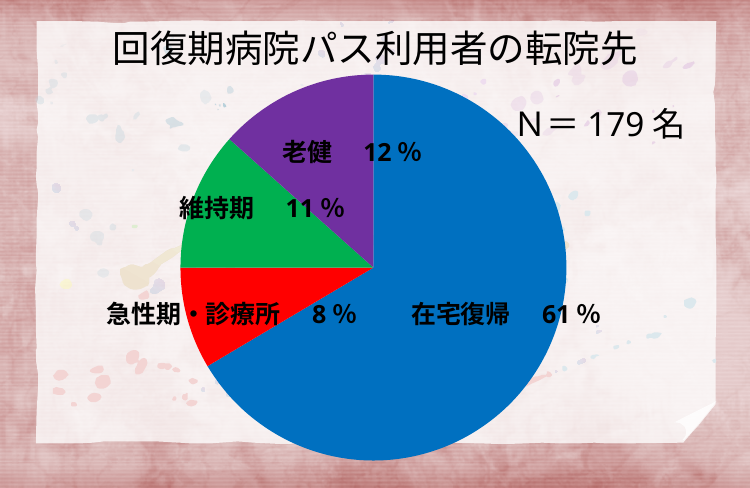
Which is larger, the share for 維持期 or the share for 急性期・診療所? 維持期 Which category has the smallest slice of the pie? 急性期・診療所 What share of the pie does 急性期・診療所 represent? 8 % What is the difference in percentage points between 在宅復帰 and 老健? 49 How many categories are shown in the pie chart? 4 What kind of chart is shown on the slide? pie chart What share of the pie does 老健 represent? 12 % What is the title of the chart? 回復期病院パス利用者の転院先 What share of the pie does 維持期 represent? 11 % Which category has the largest slice of the pie? 在宅復帰 What is the sample size (N) stated on the slide? 179 名